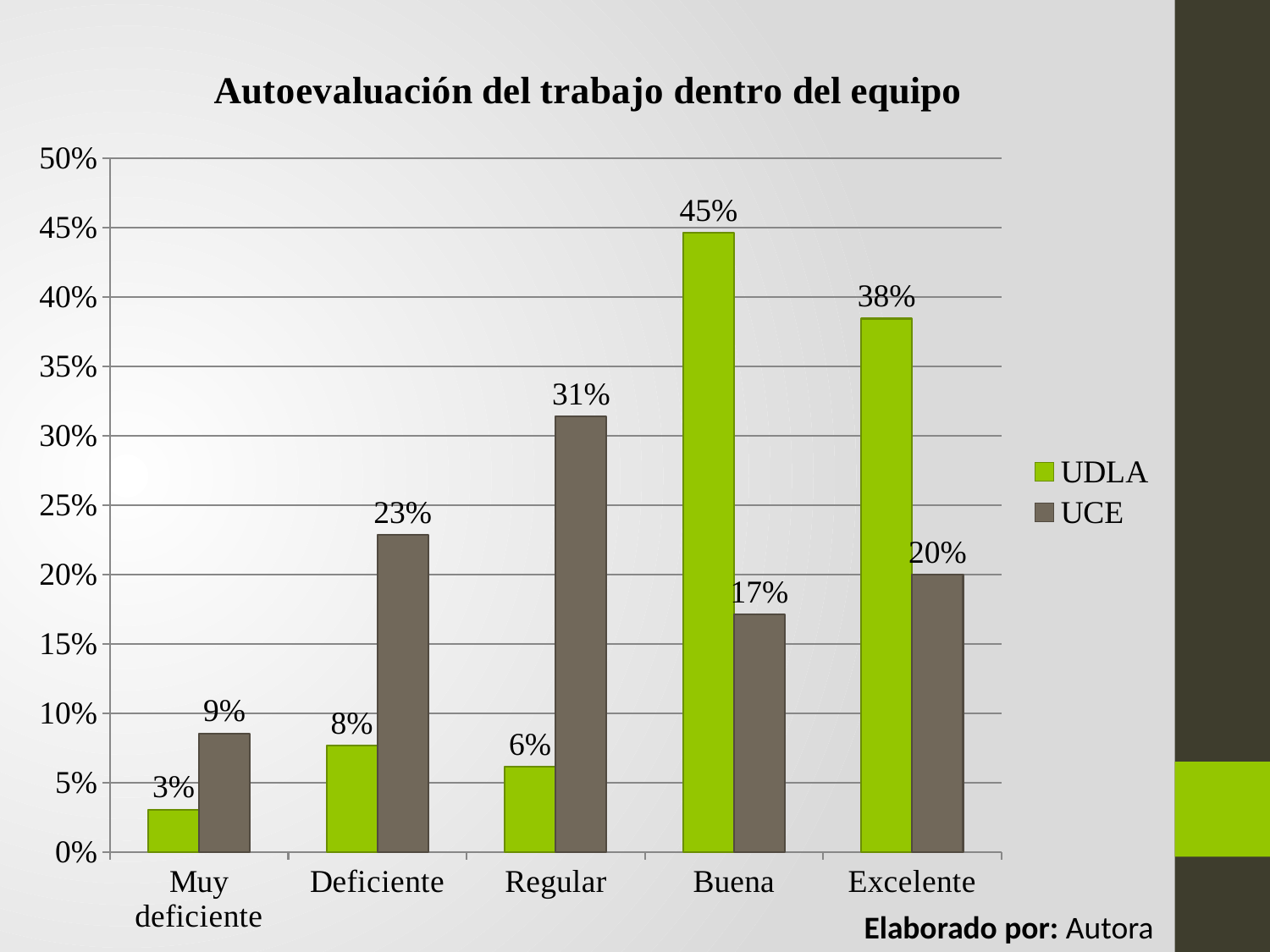
What is the UCE value for Excelente? 20% How many categories are shown on the x axis? 5 What is the UDLA value for Buena? 45% Which category has the lowest UCE value? Muy deficiente How many series does the legend list? 2 What is the UDLA value for Muy deficiente? 3% Which category has the highest UDLA value? Buena What is the title of the chart? Autoevaluación del trabajo dentro del equipo What kind of chart is shown on the slide? Bar chart What is the difference between the UDLA and UCE values for Buena? 28% What is the UCE value for Regular? 31% Which is larger for Deficiente, the UDLA value or the UCE value? UCE